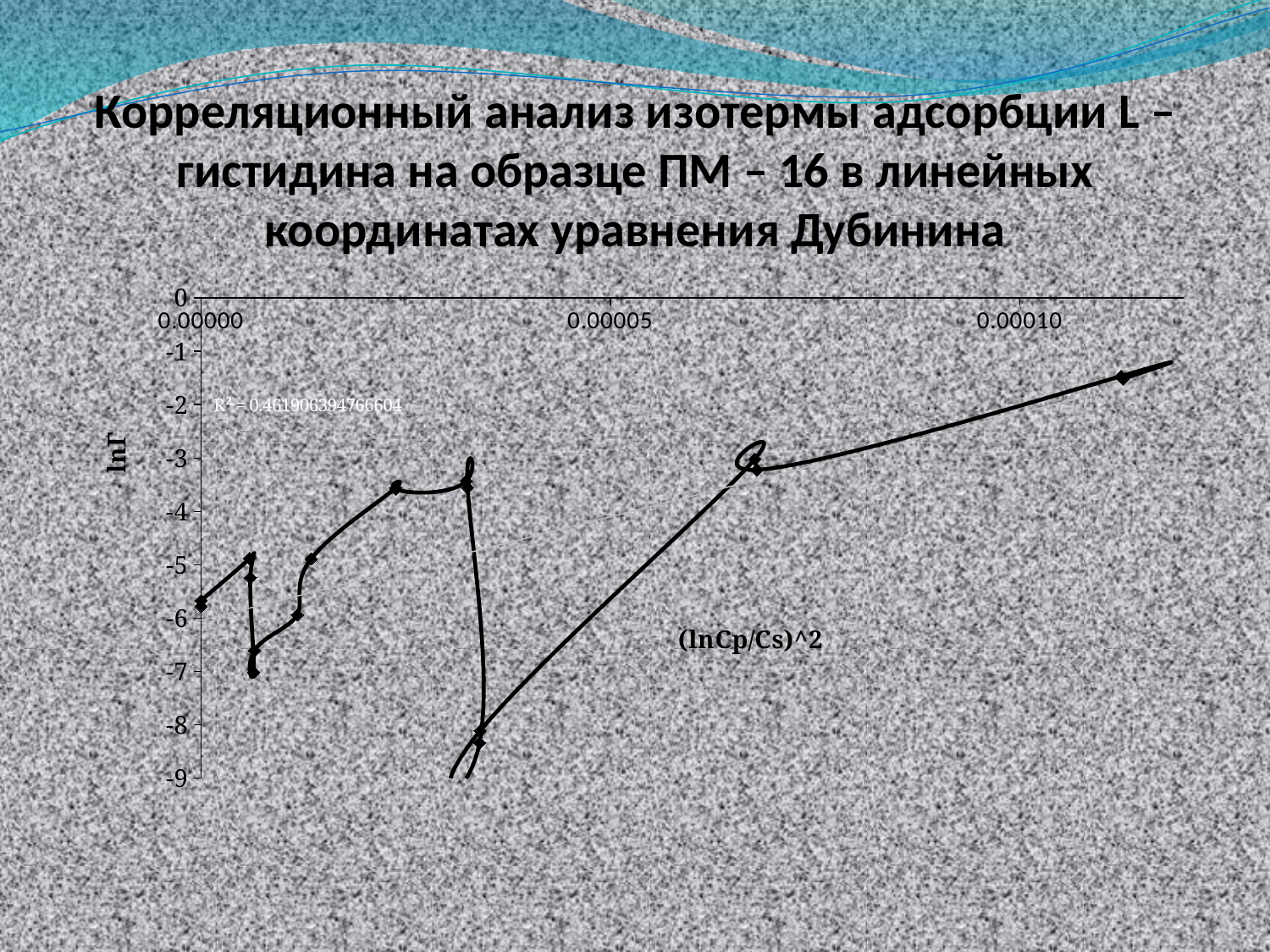
Is the highest lnГ point on the chart located at the left end or the right end of the x axis? right end Is the lnГ value of the rightmost point on the chart greater or less than -2? greater Which has the higher lnГ value: the rightmost point or the leftmost point? the rightmost point Between the point near x = 0.00006 and the rightmost point, do the lnГ values rise or fall along the x axis? rise Is the lnГ value of the leftmost point on the chart greater or less than -5? less Is the lnГ value of the lowest point on the chart greater or less than -7? less What kind of chart is shown on the slide? line chart What is the label of the x axis of the chart? (lnCp/Cs)^2 What R² value is printed on the chart? R² = 0.461906394766604